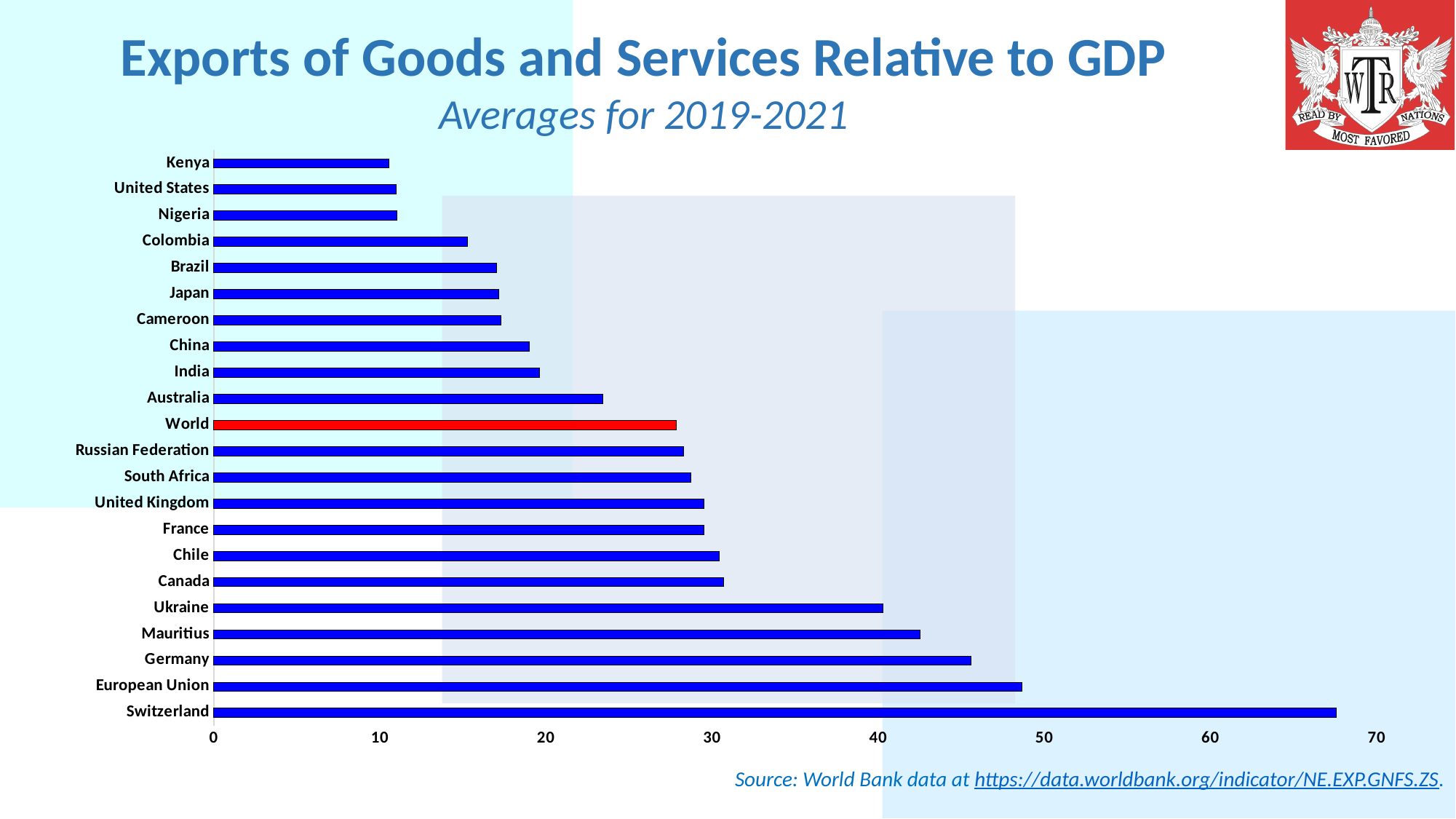
Which country or region has the highest exports relative to GDP on the chart? Switzerland What period do the averages in the chart cover, according to the subtitle? 2019-2021 Is the value for the European Union greater or less than 40? greater Is the value for World greater or less than 30? less Which bar is shown in red rather than blue? World What kind of chart is shown on the slide? bar chart Which has a larger value, World or Australia? World Is the value for Colombia greater or less than 20? less How many countries or regions are listed on the chart? 22 Which has a larger value, Germany or Ukraine? Germany